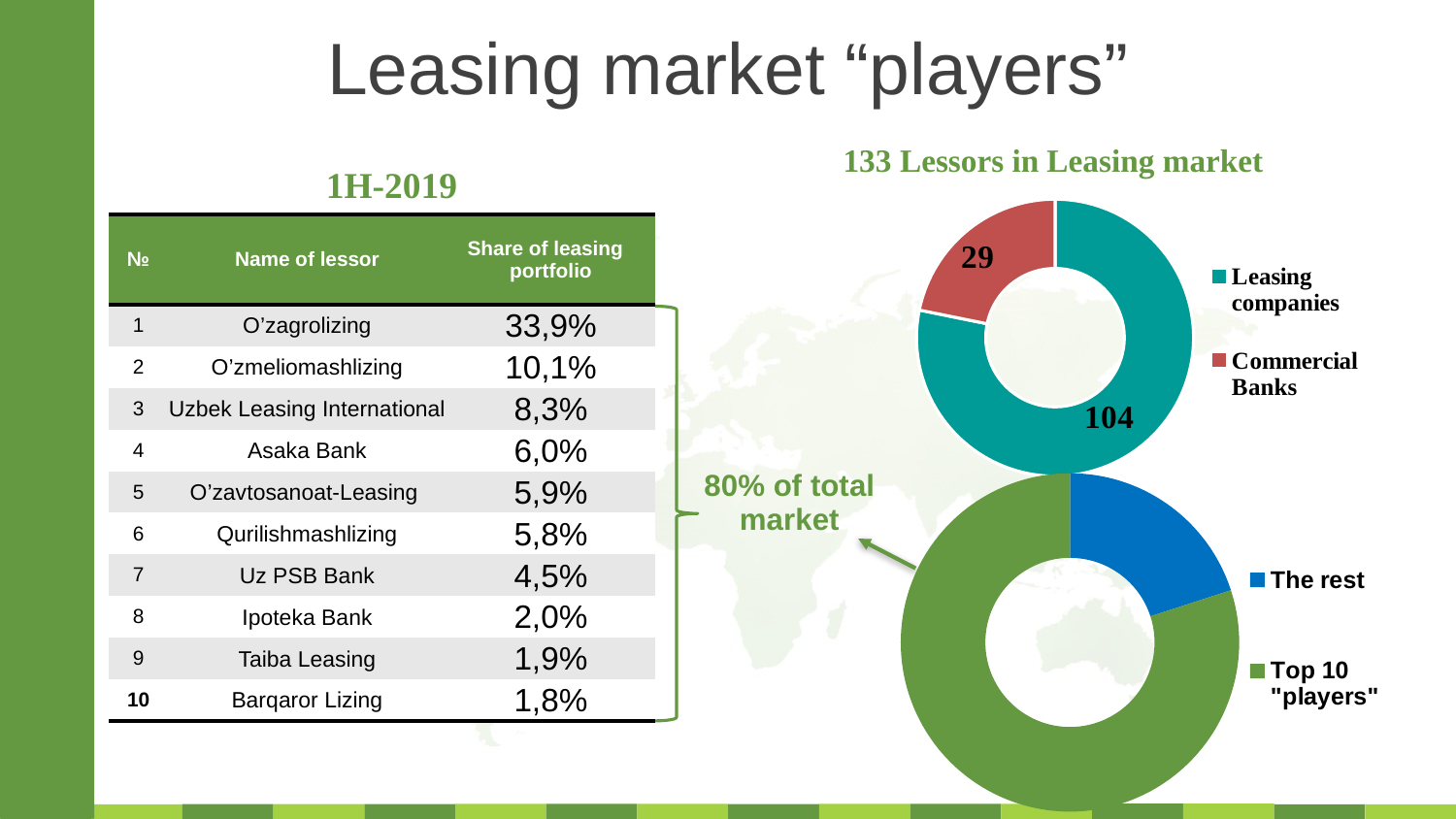
In the top chart titled "133 Lessors in Leasing market", how many categories does the legend list? 2 In the top chart titled "133 Lessors in Leasing market", what is the value for Commercial Banks? 29 In the top chart titled "133 Lessors in Leasing market", what is the total of Leasing companies and Commercial Banks? 133 In the top chart titled "133 Lessors in Leasing market", what is the value for Leasing companies? 104 In the top chart titled "133 Lessors in Leasing market", what colour is the slice for Commercial Banks? Red In the top chart titled "133 Lessors in Leasing market", which category has the highest value? Leasing companies What kind of chart is the top chart titled "133 Lessors in Leasing market"? Donut chart In the bottom chart on the right, how many categories does the legend list? 2 In the top chart titled "133 Lessors in Leasing market", what is the difference between Leasing companies and Commercial Banks? 75 In the bottom chart on the right, what colour is the slice for "The rest"? Blue In the bottom chart on the right, which slice is larger: "The rest" or "Top 10 "players""? Top 10 "players" In the top chart titled "133 Lessors in Leasing market", which category has the lowest value? Commercial Banks